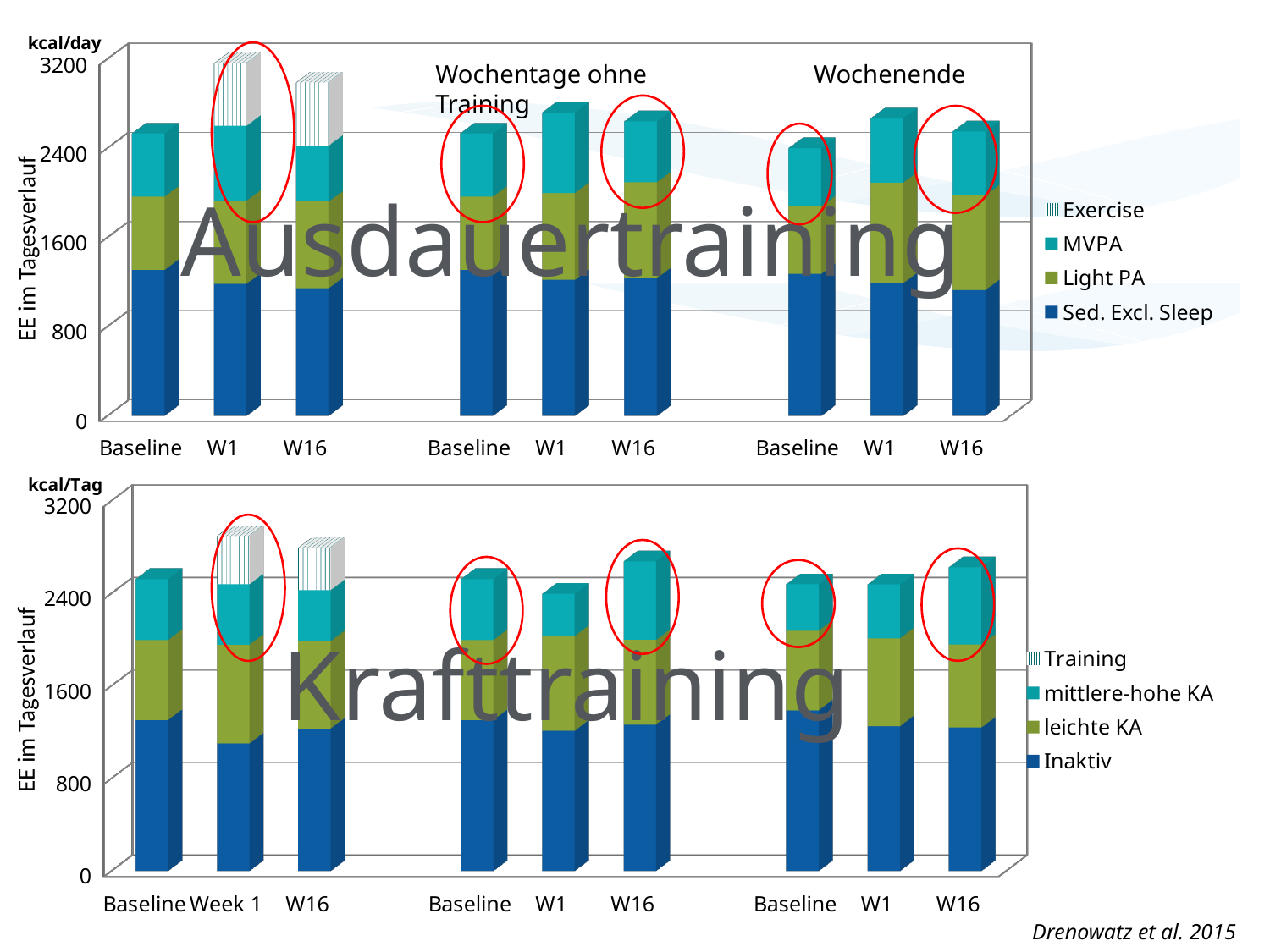
In the bottom chart (Krafttraining), is the total of the W16 bar in the first group greater or less than 2400? greater In the bottom chart (Krafttraining), which bar in the first group is the tallest? Week 1 What is the y-axis label of the bottom chart (Krafttraining)? EE im Tagesverlauf In the bottom chart (Krafttraining), is the Inaktiv segment of the Baseline bar in the first group greater or less than 1600? less How many series does the legend of the top chart (Ausdauertraining) list? 4 How many bars are plotted in the bottom chart (Krafttraining)? 9 How many series does the legend of the bottom chart (Krafttraining) list? 4 In the top chart (Ausdauertraining), is the total of the W16 bar in the first group greater or less than 2400? greater In the top chart (Ausdauertraining), which bar in the first group is the tallest? W1 In the top chart (Ausdauertraining), which legend entry is shown with a hatched pattern? Exercise What kind of chart is the top chart (Ausdauertraining)? Stacked bar chart